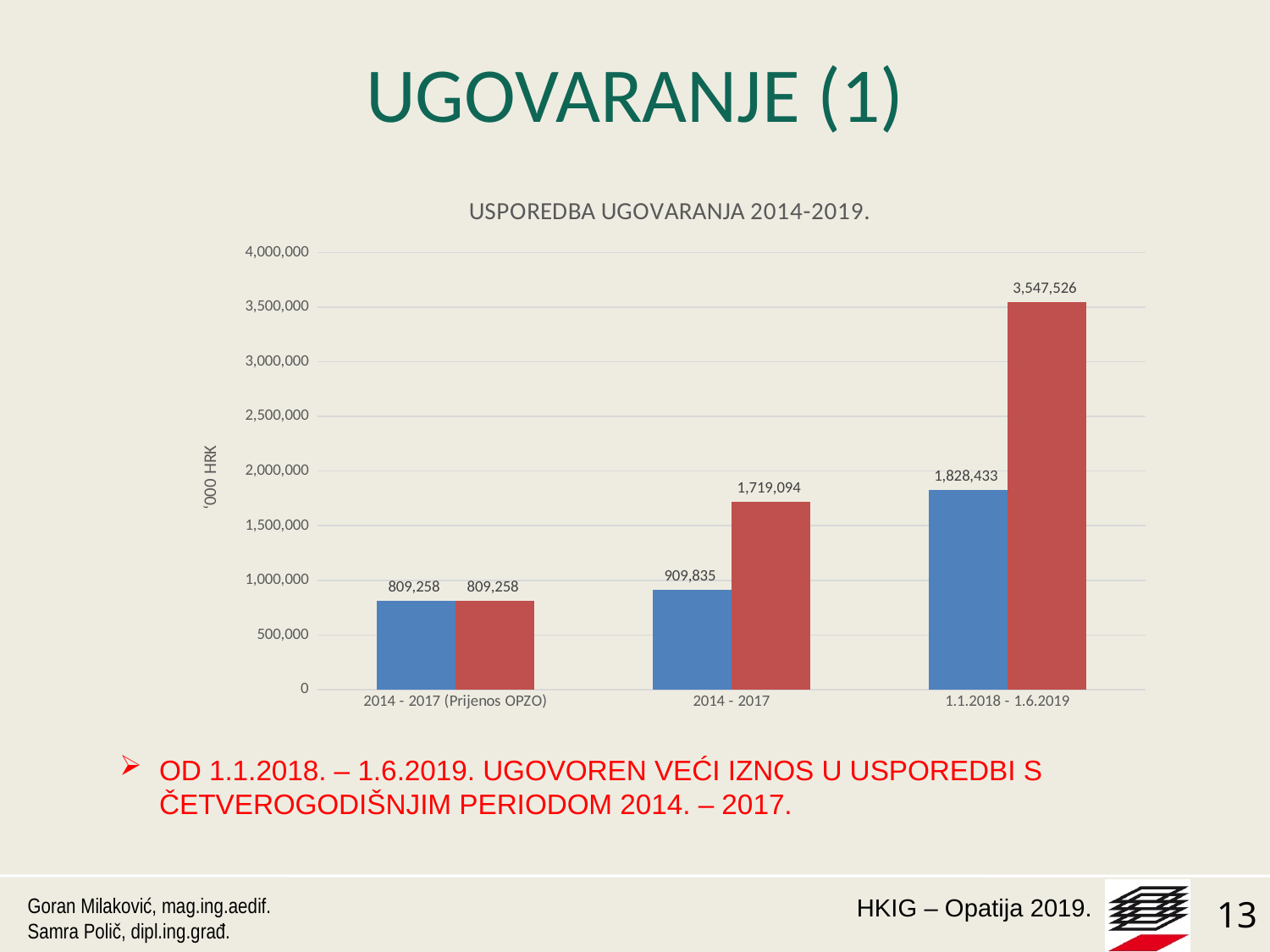
How many categories are shown on the x axis? 3 Which category has the highest red bar? 1.1.2018 - 1.6.2019 What is the value of the red bar for 1.1.2018 - 1.6.2019? 3,547,526 What is the label on the vertical axis of the chart? '000 HRK Which is larger: the blue bar for 1.1.2018 - 1.6.2019 or the red bar for 2014 - 2017? The blue bar for 1.1.2018 - 1.6.2019 What is the difference between the red bar and the blue bar for 2014 - 2017? 809,259 Which category has the lowest blue bar? 2014 - 2017 (Prijenos OPZO) What is the difference between the red bar and the blue bar for 1.1.2018 - 1.6.2019? 1,719,093 What is the value of the blue bar for 2014 - 2017 (Prijenos OPZO)? 809,258 What is the value of the blue bar for 2014 - 2017? 909,835 What kind of chart is shown on the slide? Bar chart Is the value of the red bar for 1.1.2018 - 1.6.2019 greater or less than 3,000,000? greater